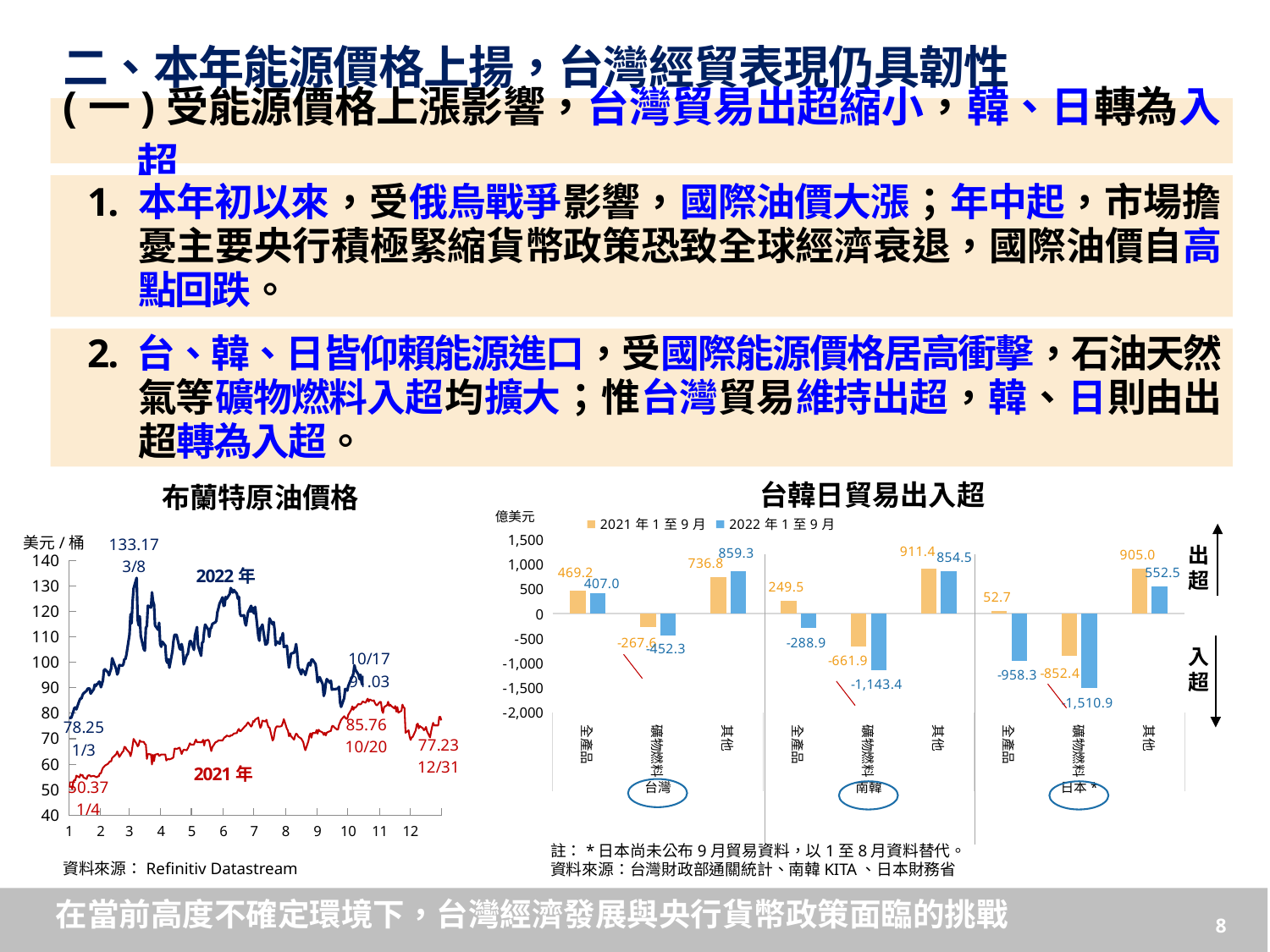
In the 台韓日貿易出入超 chart, which is larger for 台灣 其他: the 2021年1至9月 value or the 2022年1至9月 value? 2022年1至9月 (859.3) In the 台韓日貿易出入超 chart, what is the 2022年1至9月 value for 其他 for 日本*? 552.5 What kind of chart is the 台韓日貿易出入超 chart? Bar chart In the 布蘭特原油價格 chart, what is the peak value labelled on the 2022年 line, and on what date? 133.17 on 3/8 What kind of chart is the 布蘭特原油價格 chart? Line chart In the 布蘭特原油價格 chart, what unit is shown on the y axis? 美元/桶 In the 台韓日貿易出入超 chart, what is the 2021年1至9月 value for 全產品 for 台灣? 469.2 In the 台韓日貿易出入超 chart, what is the 2022年1至9月 value for 礦物燃料 for 南韓? -1,143.4 In the 台韓日貿易出入超 chart, what is the difference between the 2021年1至9月 and 2022年1至9月 values for 全產品 for 日本*? 1,011.0 In the 布蘭特原油價格 chart, what is the value labelled for the 2021年 line on 12/31? 77.23 In the 台韓日貿易出入超 chart, which bar has the lowest value? 日本* 礦物燃料, 2022年1至9月 (-1,510.9) In the 台韓日貿易出入超 chart, how many series does the legend list? 2